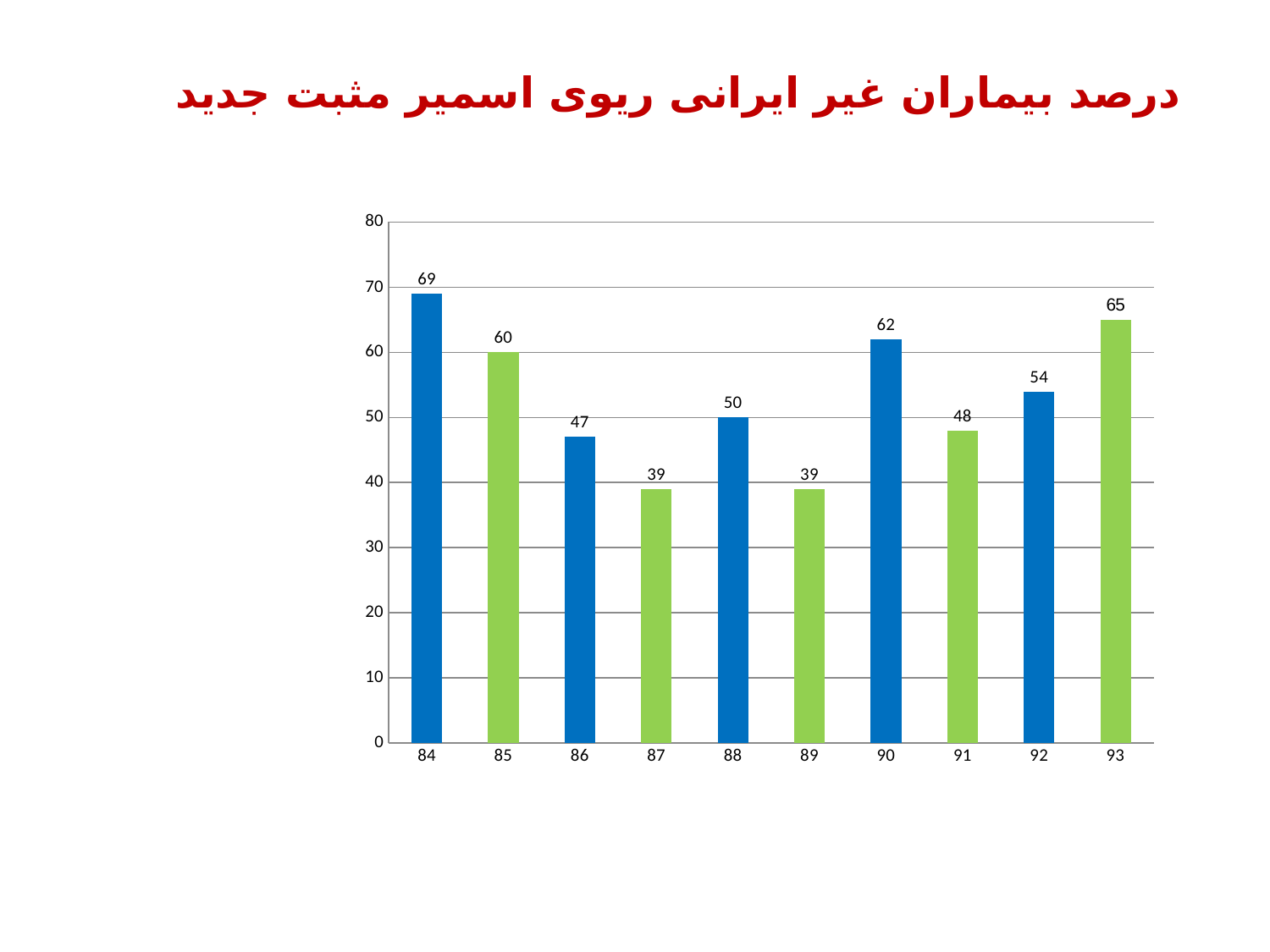
What is the value for 84? 69 What colour is the bar for 85? green What is the difference between the values for 84 and 85? 9 Which category has the highest value? 84 Is the value for 86 greater or less than 50? less Do the values rise or fall from 91 to 93? rise What is the value for 93? 65 Which is larger, the value for 88 or the value for 92? 92 What is the value for 87? 39 How many categories are shown on the x axis? 10 What kind of chart is shown on the slide? bar chart What is the difference between the values for 90 and 91? 14